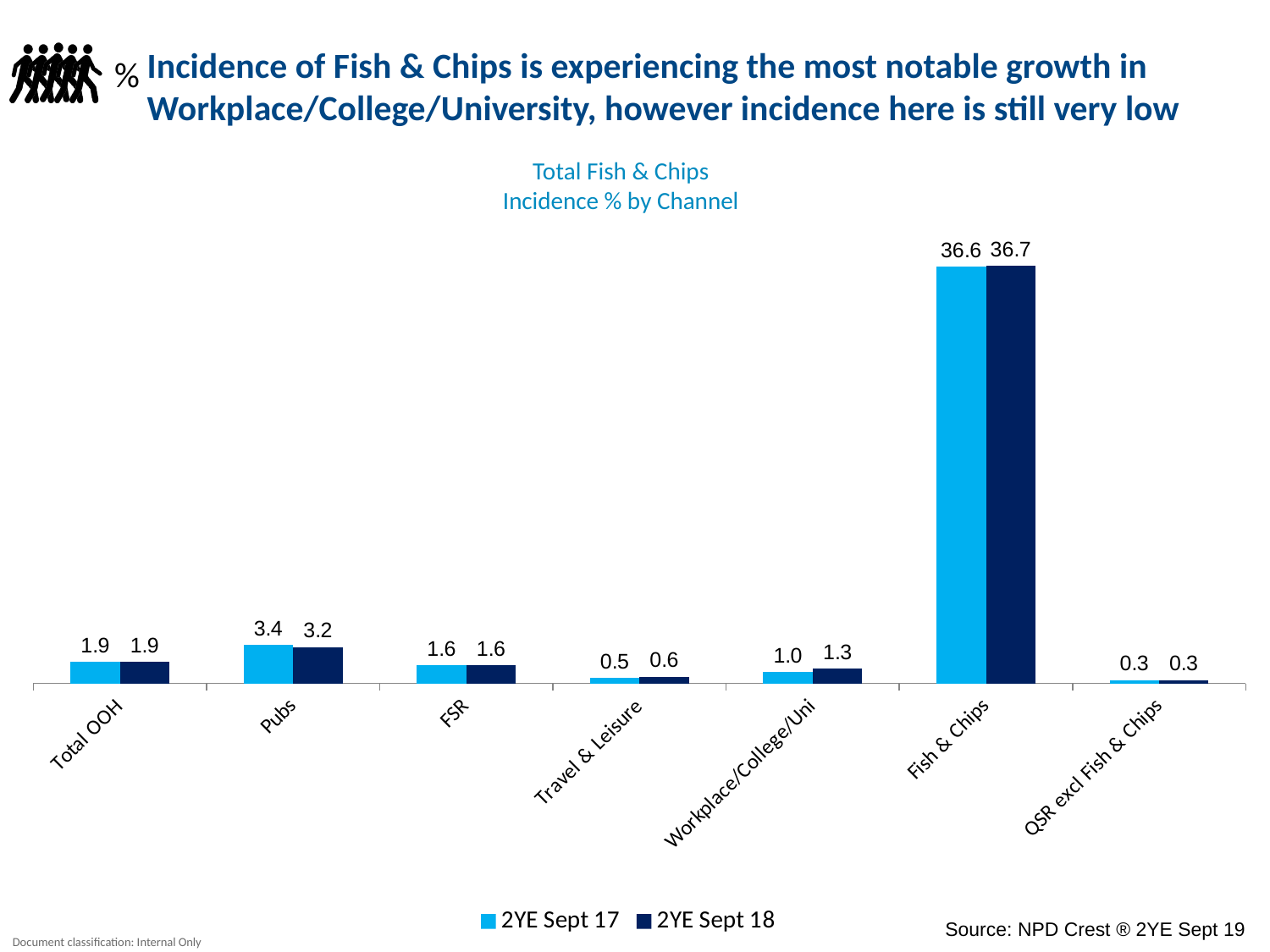
What is the value for Pubs in the 2YE Sept 17 series? 3.4 Which is larger for Travel & Leisure: the 2YE Sept 17 value or the 2YE Sept 18 value? 2YE Sept 18 What is the title of the chart? Total Fish & Chips Incidence % by Channel How many channels are shown on the x axis? 7 What is the difference between the 2YE Sept 17 and 2YE Sept 18 values for Pubs? 0.2 Which channel has the highest value in the 2YE Sept 18 series? Fish & Chips What is the difference between the 2YE Sept 18 and 2YE Sept 17 values for Workplace/College/Uni? 0.3 What kind of chart is shown on the slide? Bar chart How many series does the legend list? 2 What is the value for Fish & Chips in the 2YE Sept 18 series? 36.7 What is the value for Workplace/College/Uni in the 2YE Sept 18 series? 1.3 Which channel has the lowest value in the 2YE Sept 17 series? QSR excl Fish & Chips